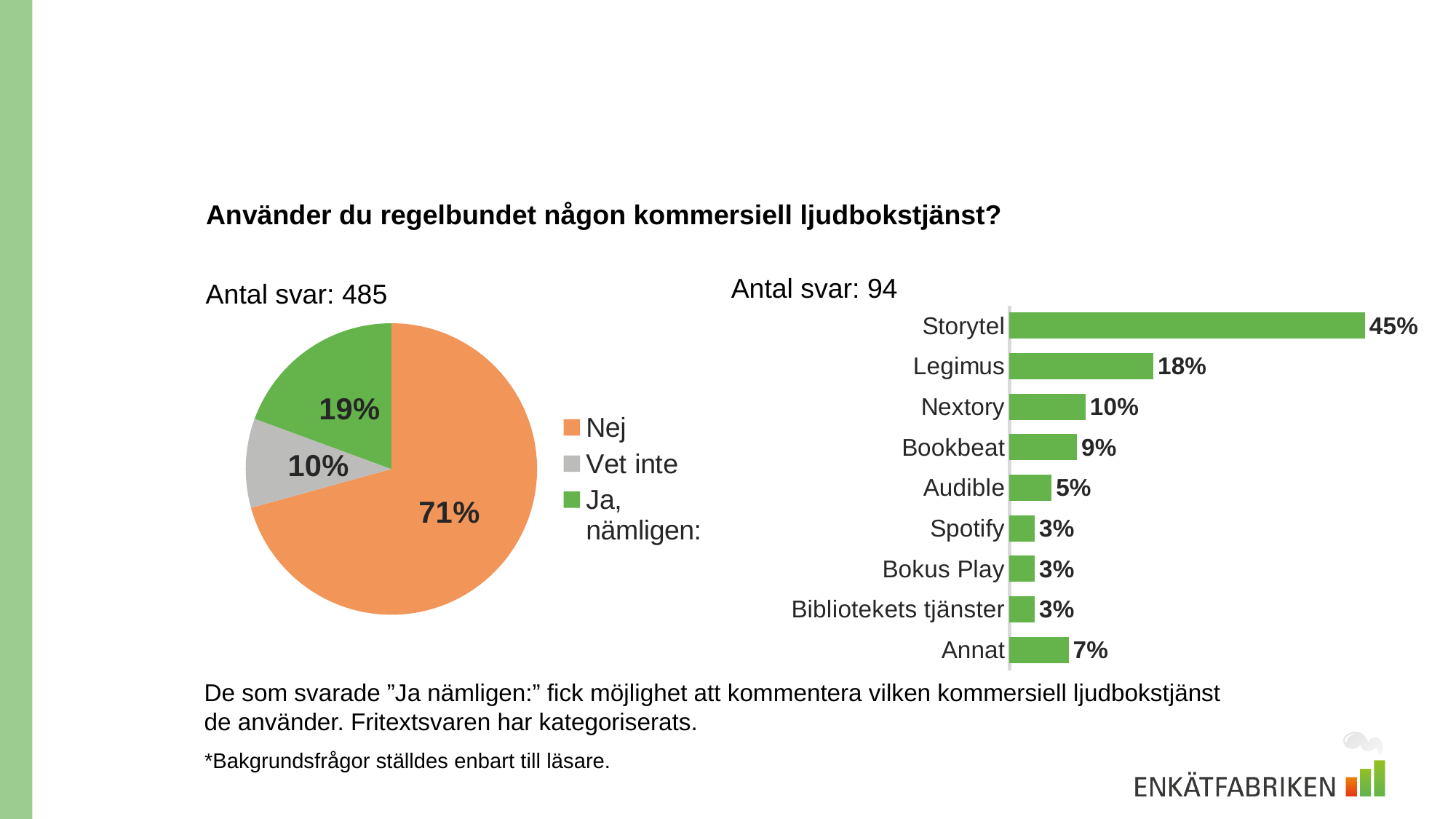
In the pie chart on the left, how many categories does the legend list? 3 In the pie chart on the left, what share of respondents answered "Vet inte"? 10% In the bar chart on the right, what is the value for Legimus? 18% In the bar chart on the right, what is the difference in percentage points between Storytel and Legimus? 27 What kind of chart is shown on the right side of the slide? Bar chart In the bar chart on the right, which is larger, Nextory or Bookbeat? Nextory In the pie chart on the left, what share of respondents answered "Nej"? 71% In the pie chart on the left, which answer has the smallest share? Vet inte In the bar chart on the right, how many categories are shown? 9 In the bar chart on the right, which service has the highest value? Storytel In the bar chart on the right, what is the value for Annat? 7% In the pie chart on the left, what is the difference in percentage points between "Nej" and "Ja, nämligen:"? 52